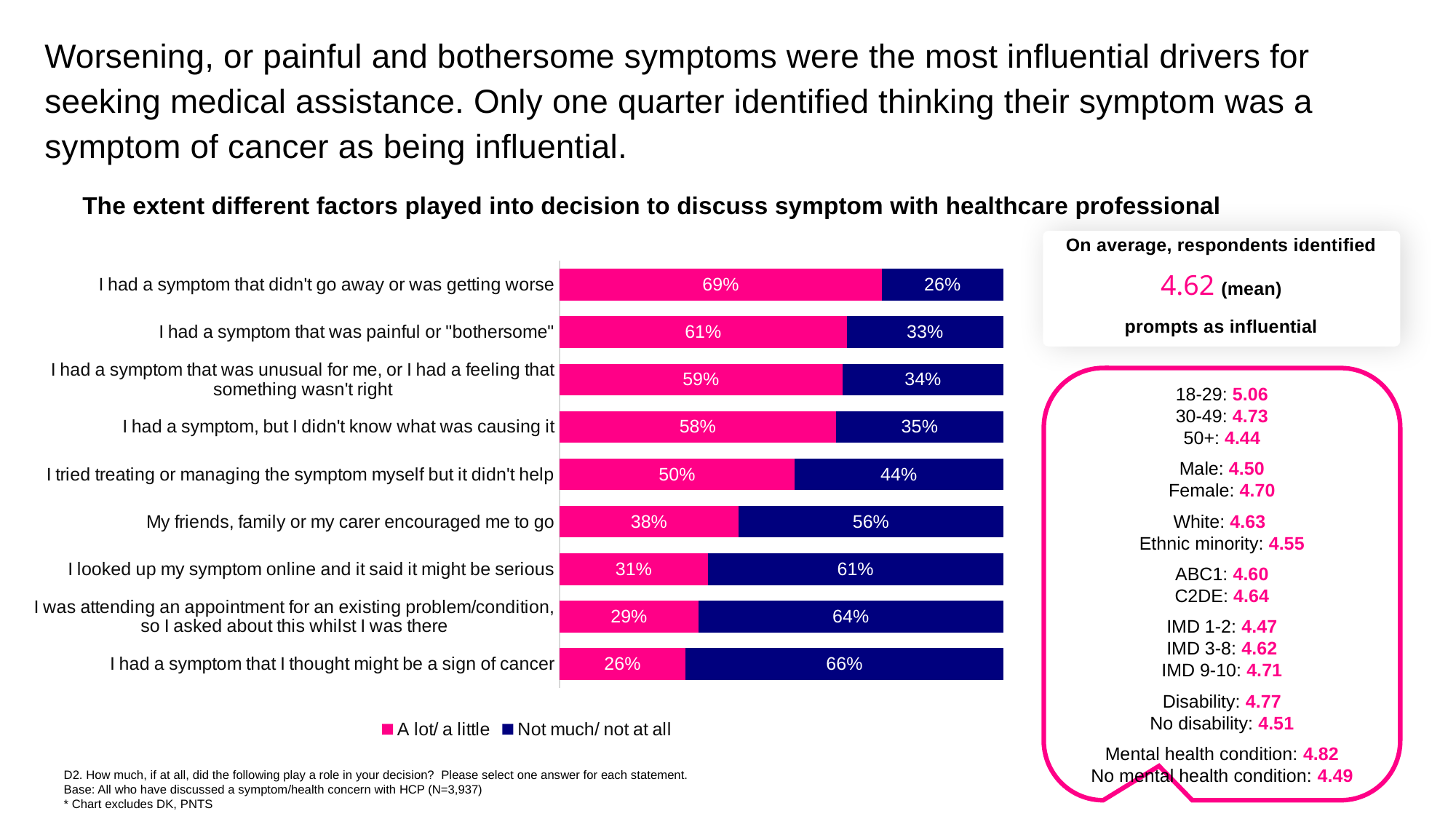
What is the "Not much/ not at all" value for "I had a symptom that I thought might be a sign of cancer"? 66% What type of chart is used to show the extent different factors played into the decision? Stacked bar chart How many series does the legend list? 2 Which statement has the highest "A lot/ a little" percentage? I had a symptom that didn't go away or was getting worse What is the title of the chart? The extent different factors played into decision to discuss symptom with healthcare professional Which is larger: the "Not much/ not at all" value for "I tried treating or managing the symptom myself but it didn't help" or for "I had a symptom, but I didn't know what was causing it"? I tried treating or managing the symptom myself but it didn't help What percentage of respondents said "I had a symptom that didn't go away or was getting worse" played a role a lot/a little? 69% What is the total of the two segments for "I was attending an appointment for an existing problem/condition, so I asked about this whilst I was there"? 93% Which statement has the lowest "A lot/ a little" percentage? I had a symptom that I thought might be a sign of cancer What is the "A lot/ a little" value for "My friends, family or my carer encouraged me to go"? 38% What is the difference between the "A lot/ a little" values for "I had a symptom that was painful or 'bothersome'" and "I looked up my symptom online and it said it might be serious"? 30% How many statements are shown in the bar chart? 9